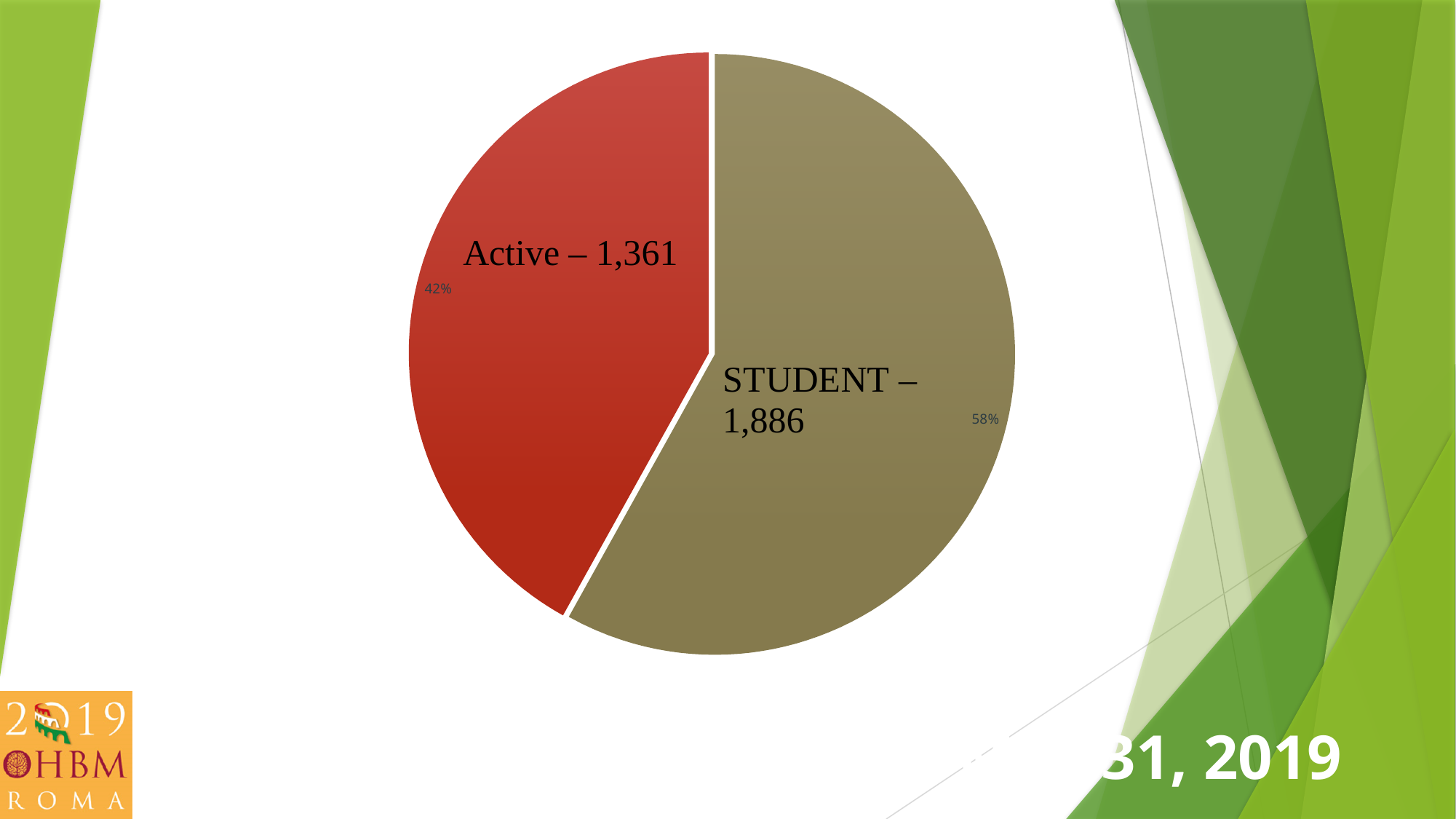
What kind of chart is shown on the slide? pie chart Which slice is the smallest in the pie chart? Active What percentage share is labelled on the STUDENT slice? 58% What is the value shown for the STUDENT slice? 1,886 What is the value shown for the Active slice? 1,361 How many slices does the pie chart have? 2 What percentage share is labelled on the Active slice? 42% Which slice is the largest in the pie chart? STUDENT What is the total of the Active and STUDENT values? 3,247 What is the difference between the STUDENT value and the Active value? 525 Which is larger, the Active slice or the STUDENT slice? STUDENT What colour is the Active slice? red